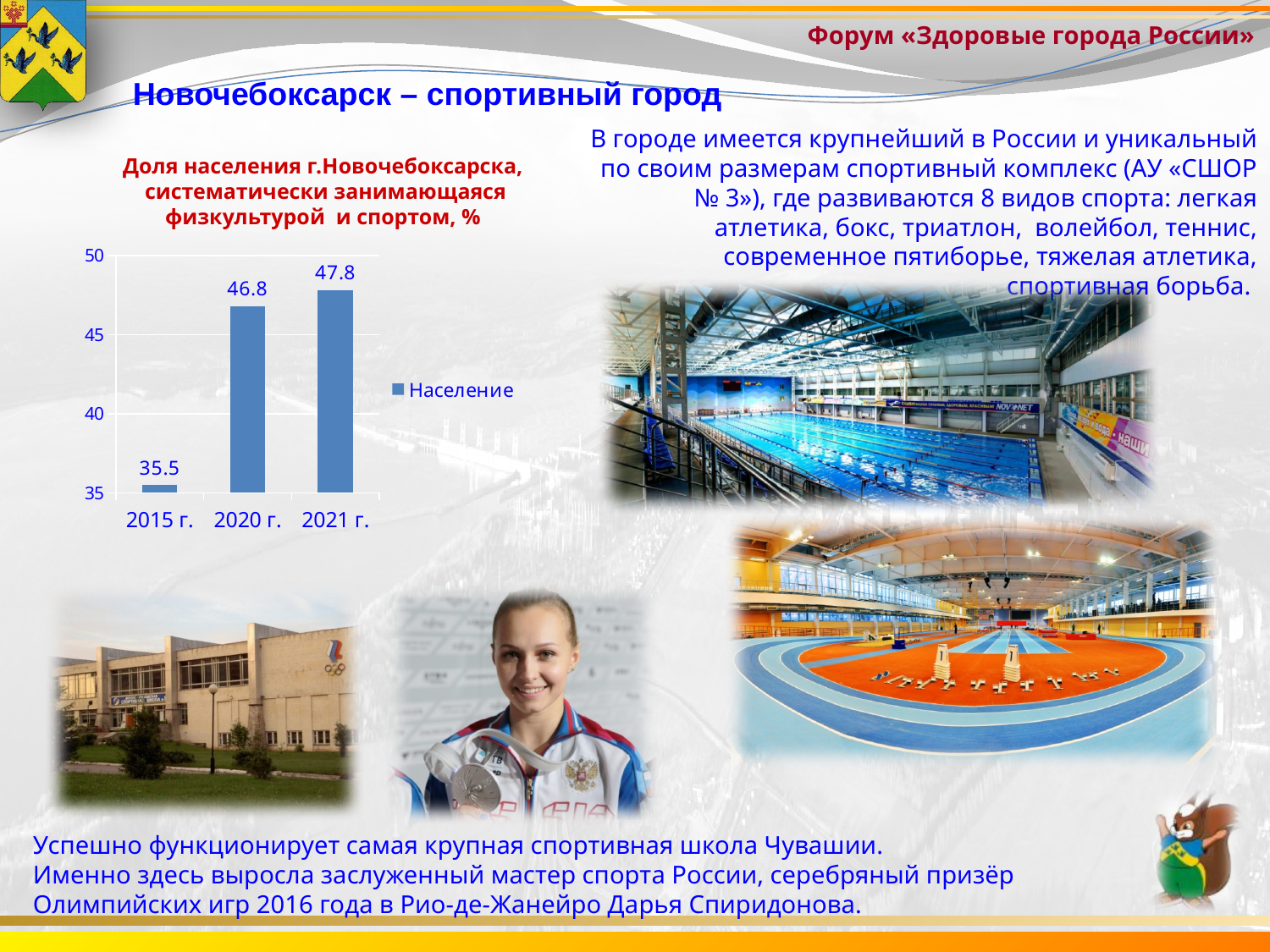
What is the difference between the values for 2021 г. and 2020 г.? 1.0 What kind of chart is shown on the slide? bar chart Which year has the lowest value in the chart? 2015 г. Do the values rise or fall from 2015 г. to 2021 г.? rise Which is larger, the value for 2015 г. or the value for 2020 г.? 2020 г. What is the difference between the values for 2020 г. and 2015 г.? 11.3 Is the value for 2021 г. greater or less than 45? greater What is the value for 2020 г. in the chart? 46.8 What is the value for 2015 г. in the chart? 35.5 Which year has the highest value in the chart? 2021 г. What is the value for 2021 г. in the chart? 47.8 How many years are shown on the x axis of the chart? 3